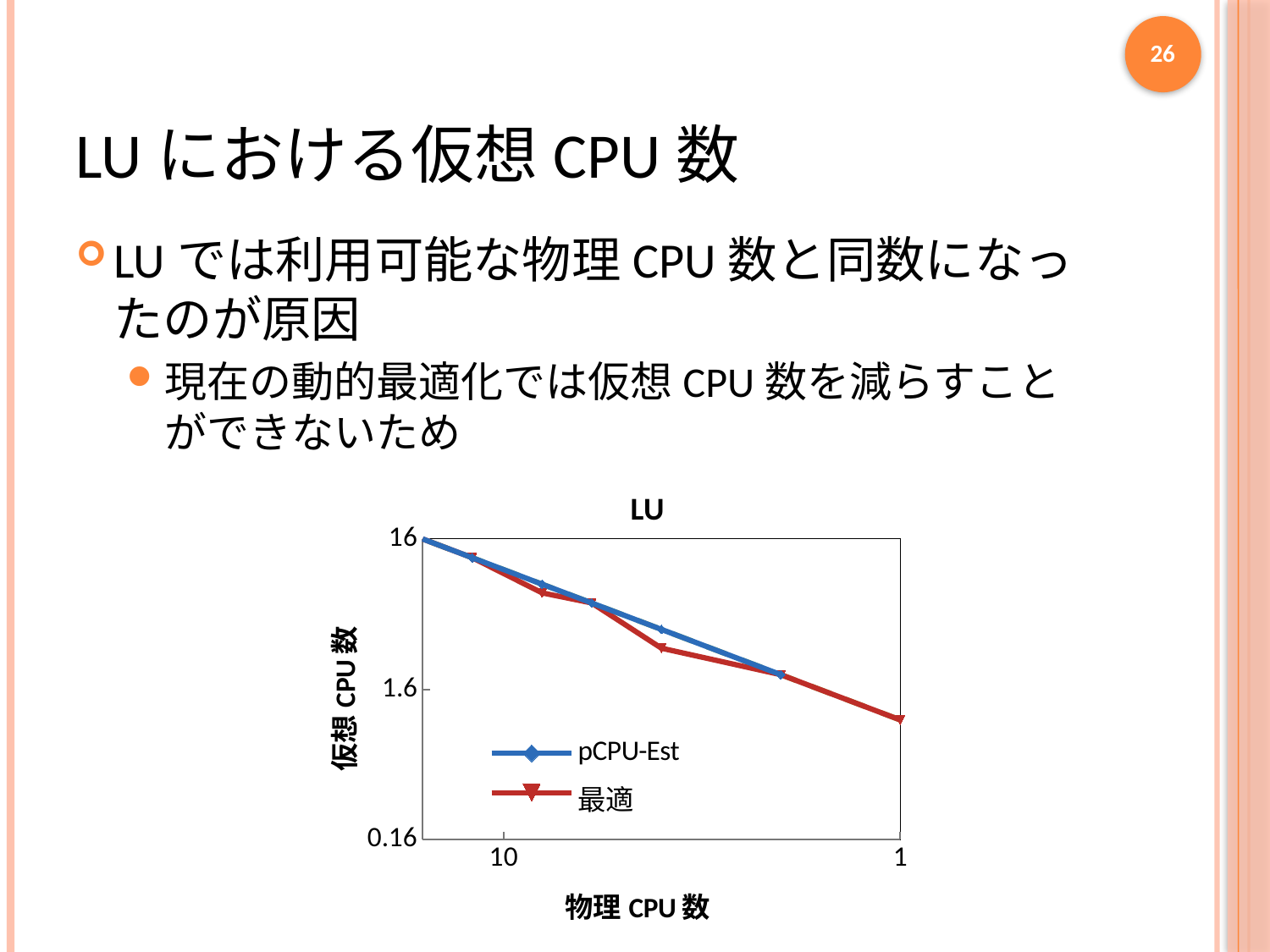
Is the value of the 最適 series at 物理 CPU 数 = 1 greater or less than 1.6? less What is the label of the y axis of the chart? 仮想 CPU 数 In the middle of the x axis, between the 10 and 1 ticks, which series dips lower, pCPU-Est or 最適? 最適 What is the title of the chart? LU What is the label of the x axis of the chart? 物理 CPU 数 What kind of chart is shown on the slide? line chart What is the value of the pCPU-Est series at its leftmost point, where it meets the top of the y axis? 16 What are the two series named in the chart legend? pCPU-Est and 最適 Do the values of the 最適 series rise or fall moving from left to right along the x axis? fall How many series does the chart legend list? 2 Do the values of the pCPU-Est series rise or fall moving from left to right along the x axis? fall